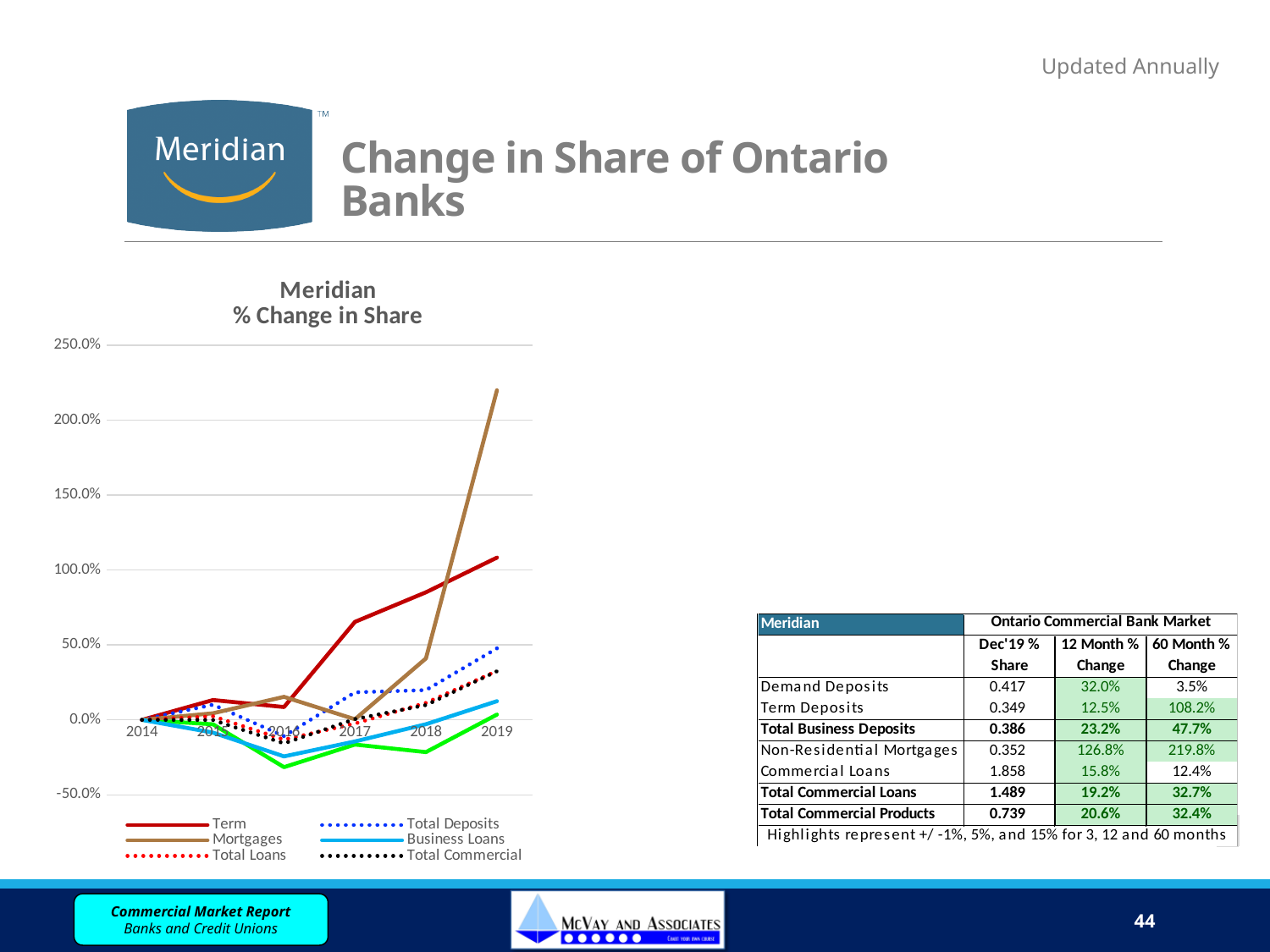
Is the value for Mortgages in 2019 greater or less than 200.0%? greater Is the value for Business Loans in 2019 greater or less than 50.0%? less How many series does the legend of the "Meridian % Change in Share" chart list? 6 Is the value for Business Loans in 2016 greater or less than 0.0%? less In 2019, which is larger on the "Meridian % Change in Share" chart: Mortgages or Term? Mortgages How many years are shown on the x axis of the "Meridian % Change in Share" chart? 6 Which series has the highest value in 2019 on the "Meridian % Change in Share" chart? Mortgages Does the Mortgages line rise or fall from 2017 to 2019? rise What kind of chart is the "Meridian % Change in Share" chart? line chart What colour is the Term line in the "Meridian % Change in Share" chart? red